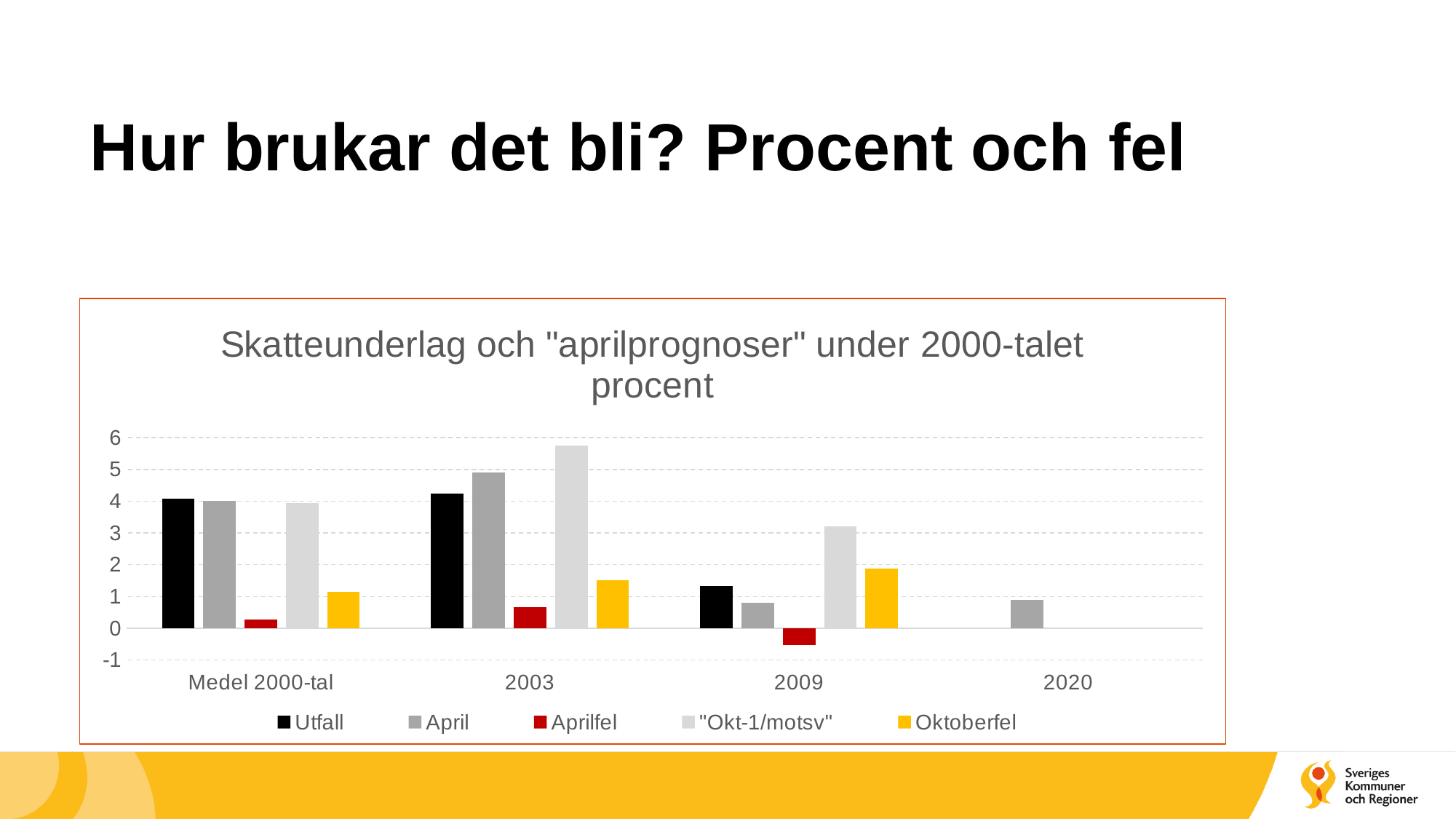
In which category is the "Okt-1/motsv" bar highest? 2003 For Medel 2000-tal, which is larger: Aprilfel or Oktoberfel? Oktoberfel In which category is the Aprilfel bar lowest? 2009 Is the value for Utfall in 2009 greater or less than 2? less How many series does the legend list? 5 What kind of chart is shown on the slide? bar chart Is the value for "Okt-1/motsv" in 2003 greater or less than 5? greater In 2003, which is larger: Utfall or April? April What colour are the Aprilfel bars? red How many categories are shown on the x axis? 4 Is the value for Oktoberfel in 2009 greater or less than 1? greater